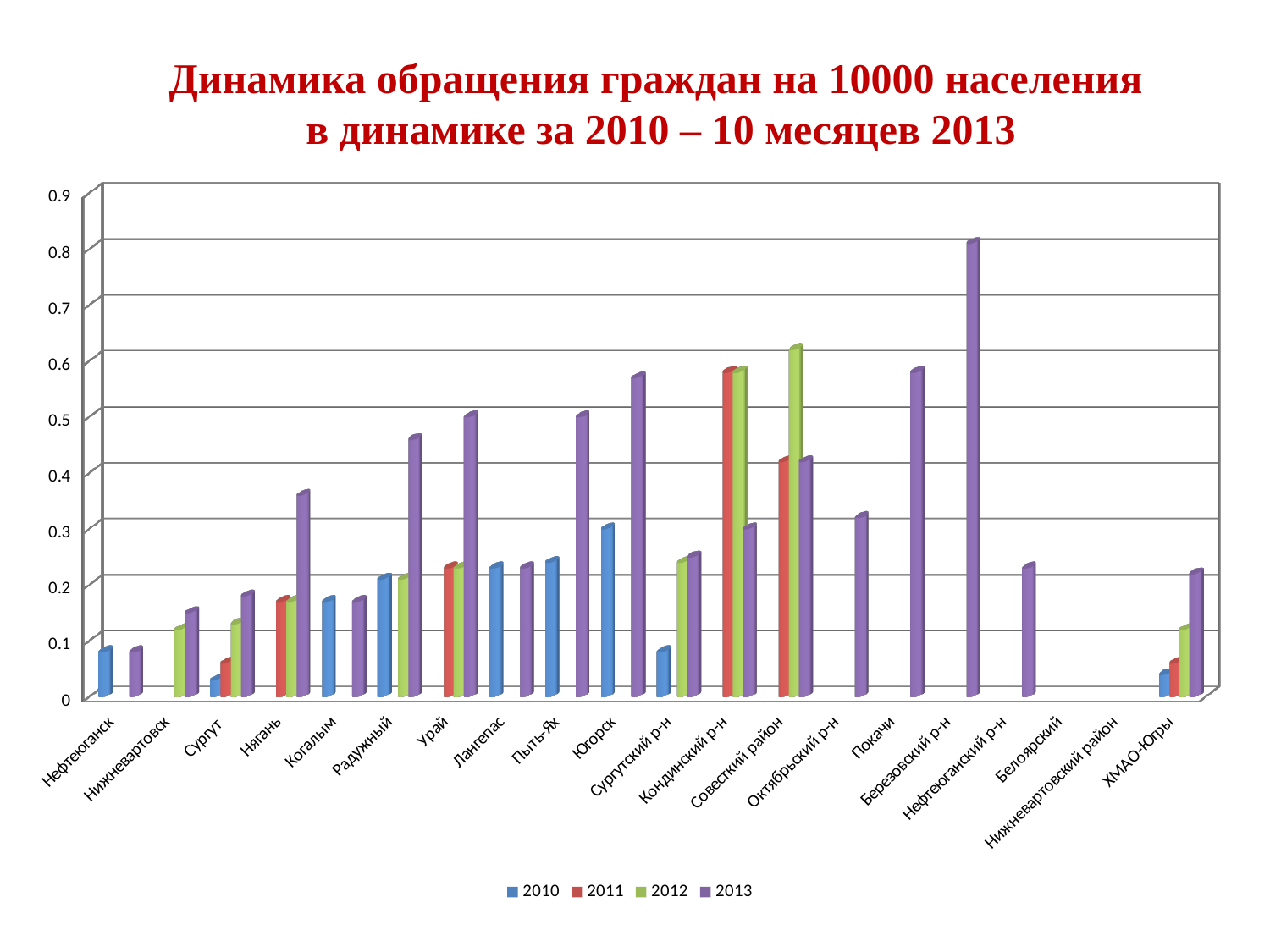
What kind of chart is shown on the slide? bar chart Is the 2013 value for Березовский р-н greater or less than 0.7? greater How many series does the legend list? 4 Is the 2012 value for Советский район greater or less than 0.5? greater For Советский район, which is larger: the 2012 value or the 2013 value? 2012 For Кондинский р-н, which is larger: the 2011 value or the 2013 value? 2011 Which category has the highest bar in the chart? Березовский р-н How many categories are shown along the x axis? 20 Is the 2013 value for Покачи greater or less than 0.5? greater Which year does the purple series in the legend represent? 2013 For Радужный, which is larger: the 2010 value or the 2013 value? 2013